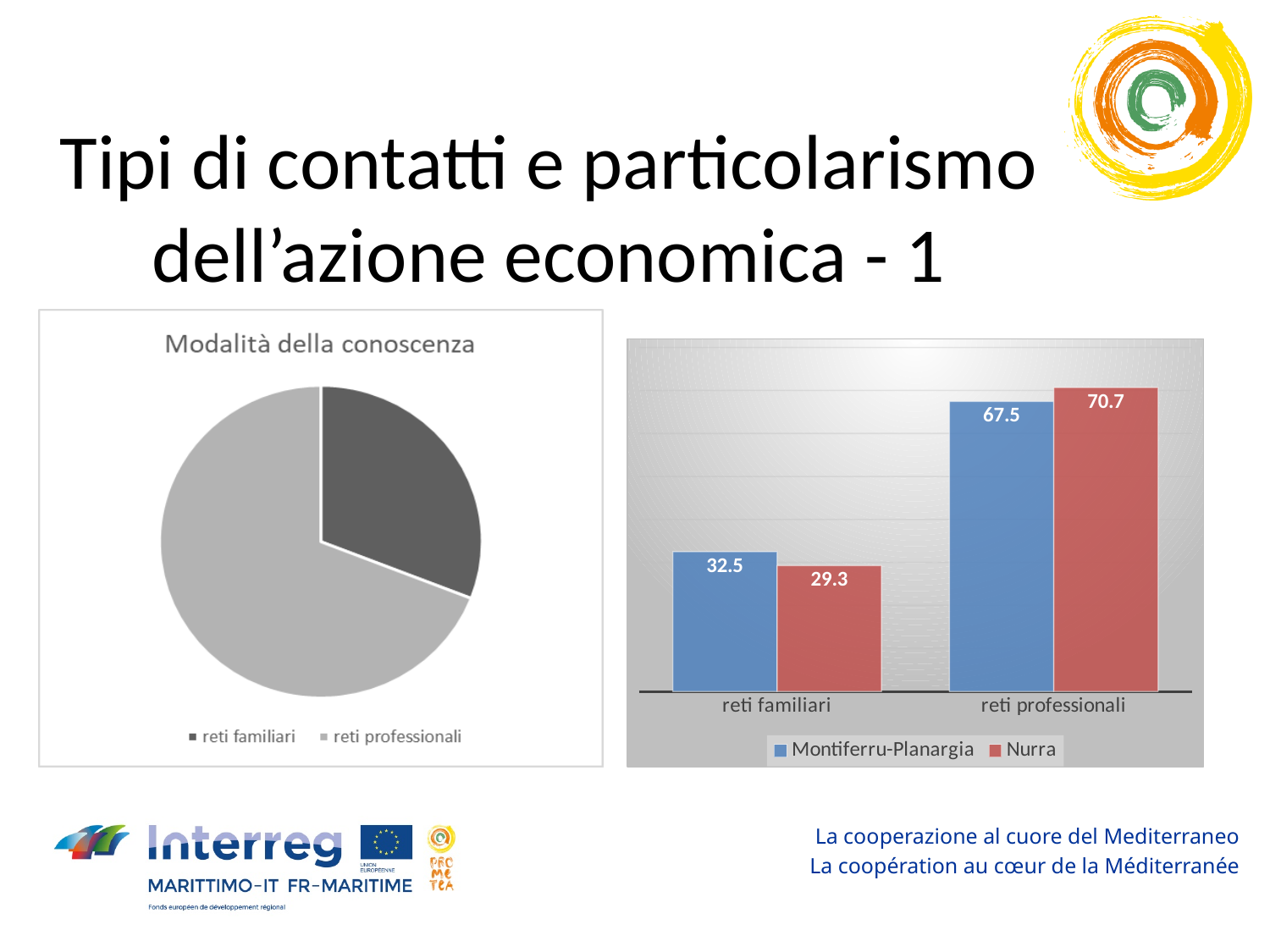
What kind of chart is the 'Modalità della conoscenza' chart on the left? Pie chart How many series does the legend of the bar chart on the right list? 2 In the bar chart on the right, which bar has the lowest value? Nurra, reti familiari In the 'Modalità della conoscenza' pie chart, which slice is larger: reti familiari or reti professionali? reti professionali In the bar chart on the right, what is the value for Montiferru-Planargia in the 'reti familiari' category? 32.5 In the bar chart on the right, which bar has the highest value? Nurra, reti professionali In the bar chart on the right, what is the value for Nurra in the 'reti familiari' category? 29.3 In the bar chart on the right, what is the value for Montiferru-Planargia in the 'reti professionali' category? 67.5 In the bar chart on the right, which is larger for 'reti familiari': Montiferru-Planargia or Nurra? Montiferru-Planargia In the bar chart on the right, what is the difference between the Nurra and Montiferru-Planargia values for 'reti professionali'? 3.2 In the bar chart on the right, what is the difference between the Montiferru-Planargia and Nurra values for 'reti familiari'? 3.2 In the bar chart on the right, what is the value for Nurra in the 'reti professionali' category? 70.7